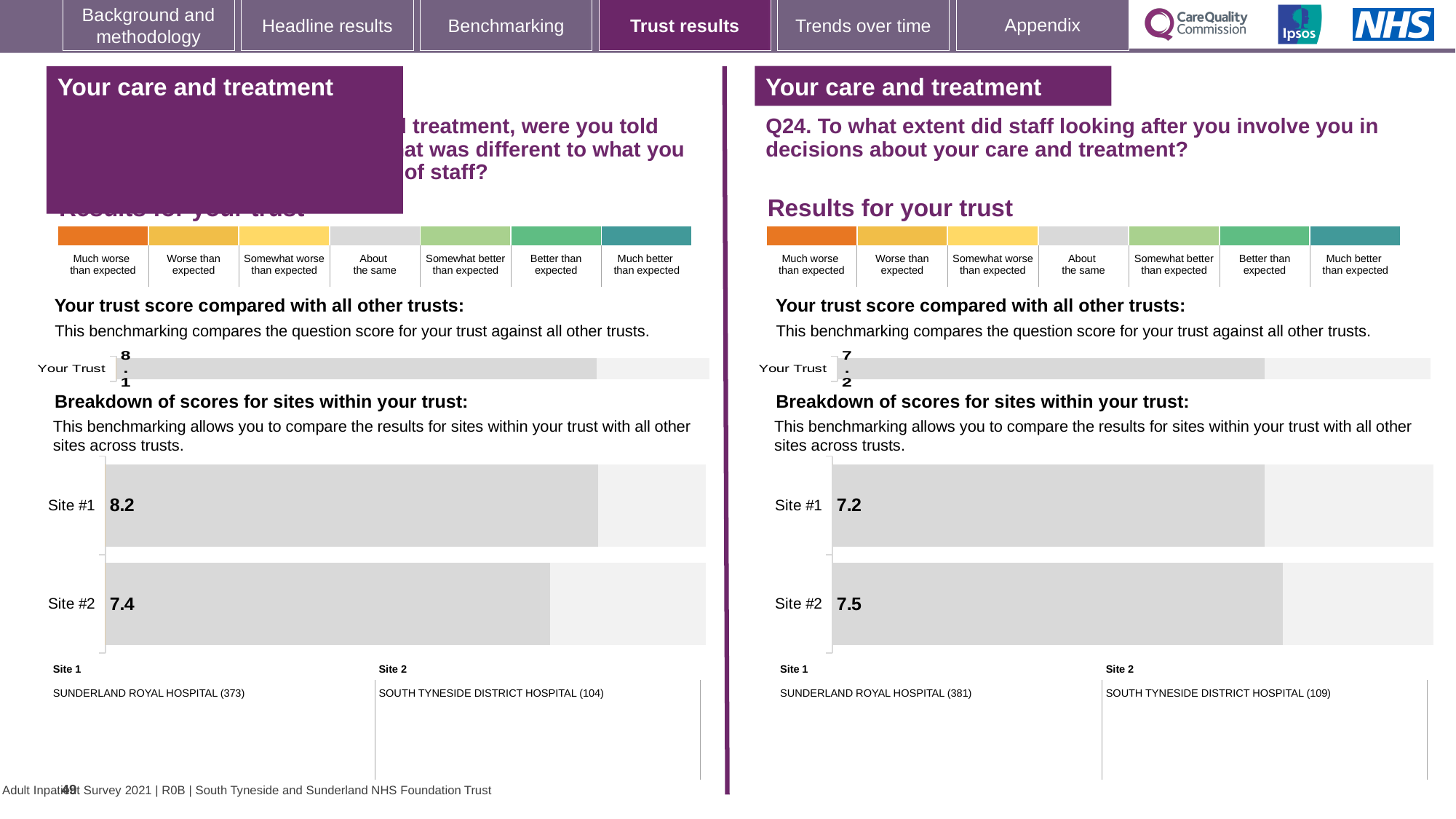
In the Q24 site breakdown chart on the right, what is the score for Site #1? 7.2 In the left-hand site breakdown chart, what is the difference between the Site #1 and Site #2 scores? 0.8 In the left-hand site breakdown chart, what is the score for Site #2? 7.4 In the Q24 site breakdown chart on the right, what is the difference between the Site #2 and Site #1 scores? 0.3 On the right-hand side of the slide (Q24), what is the score shown for Your Trust? 7.2 In the left-hand site breakdown chart, which site has the higher score? Site #1 In the Q24 site breakdown chart on the right, what is the score for Site #2? 7.5 In the left-hand site breakdown chart, what is the score for Site #1? 8.2 On the left-hand side of the slide, what is the score shown for Your Trust? 8.1 In the Q24 site breakdown chart on the right, which site has the lower score? Site #1 How many sites are shown in the Q24 site breakdown chart on the right? 2 What type of chart is used for the site breakdown on the left-hand side of the slide? Bar chart